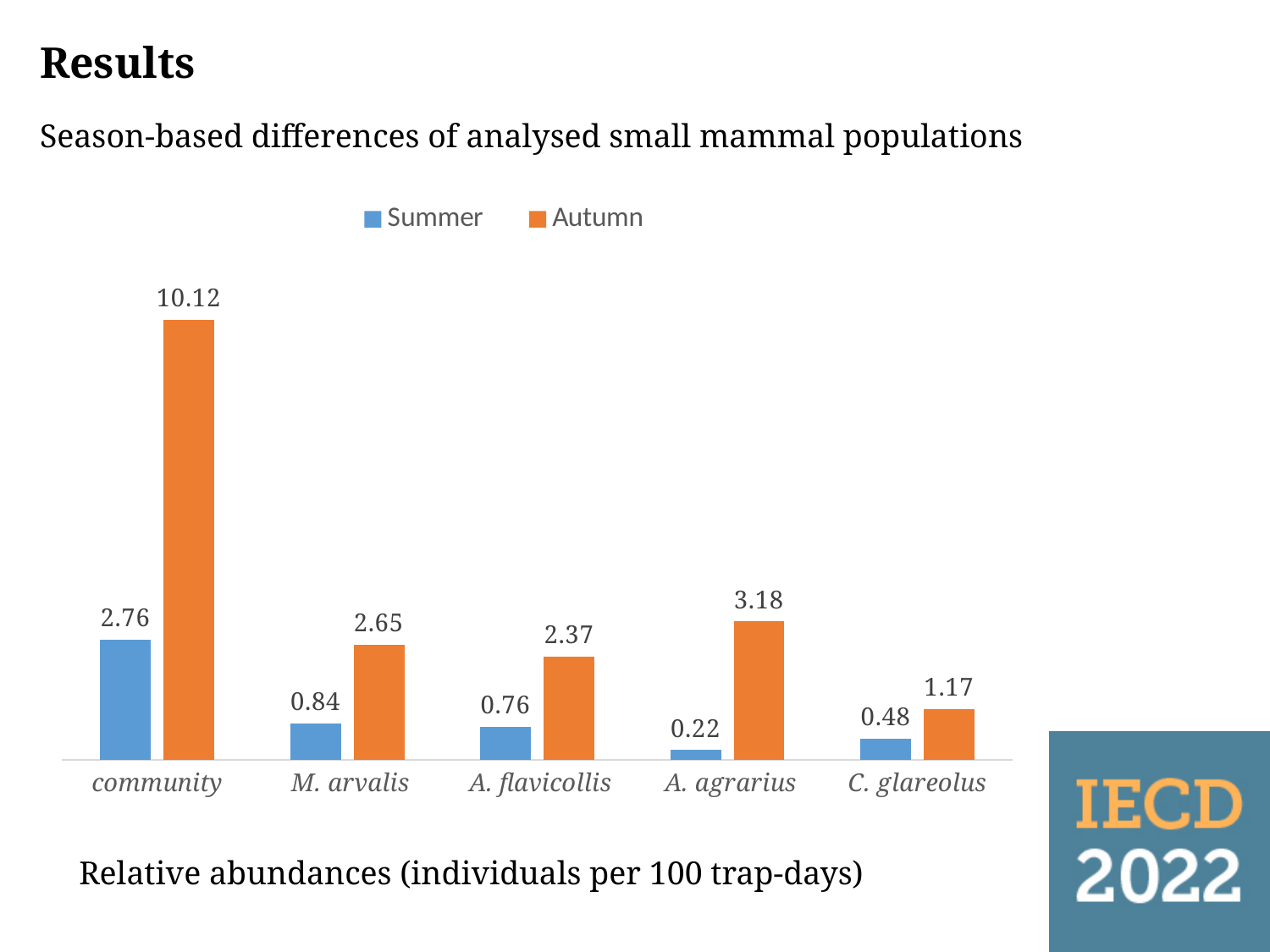
How many series does the legend list? 2 What is the Summer value for M. arvalis? 0.84 What kind of chart is shown on the slide? bar chart What is the Autumn value for C. glareolus? 1.17 Which category has the highest Autumn value? community Which is larger, the Summer value for A. flavicollis or the Summer value for C. glareolus? A. flavicollis How many categories are shown on the x axis? 5 What is the Autumn value for community? 10.12 Which category has the lowest Summer value? A. agrarius What is the difference between the Autumn values for A. agrarius and A. flavicollis? 0.81 What is the difference between the Autumn and Summer values for community? 7.36 What is the Summer value for A. agrarius? 0.22